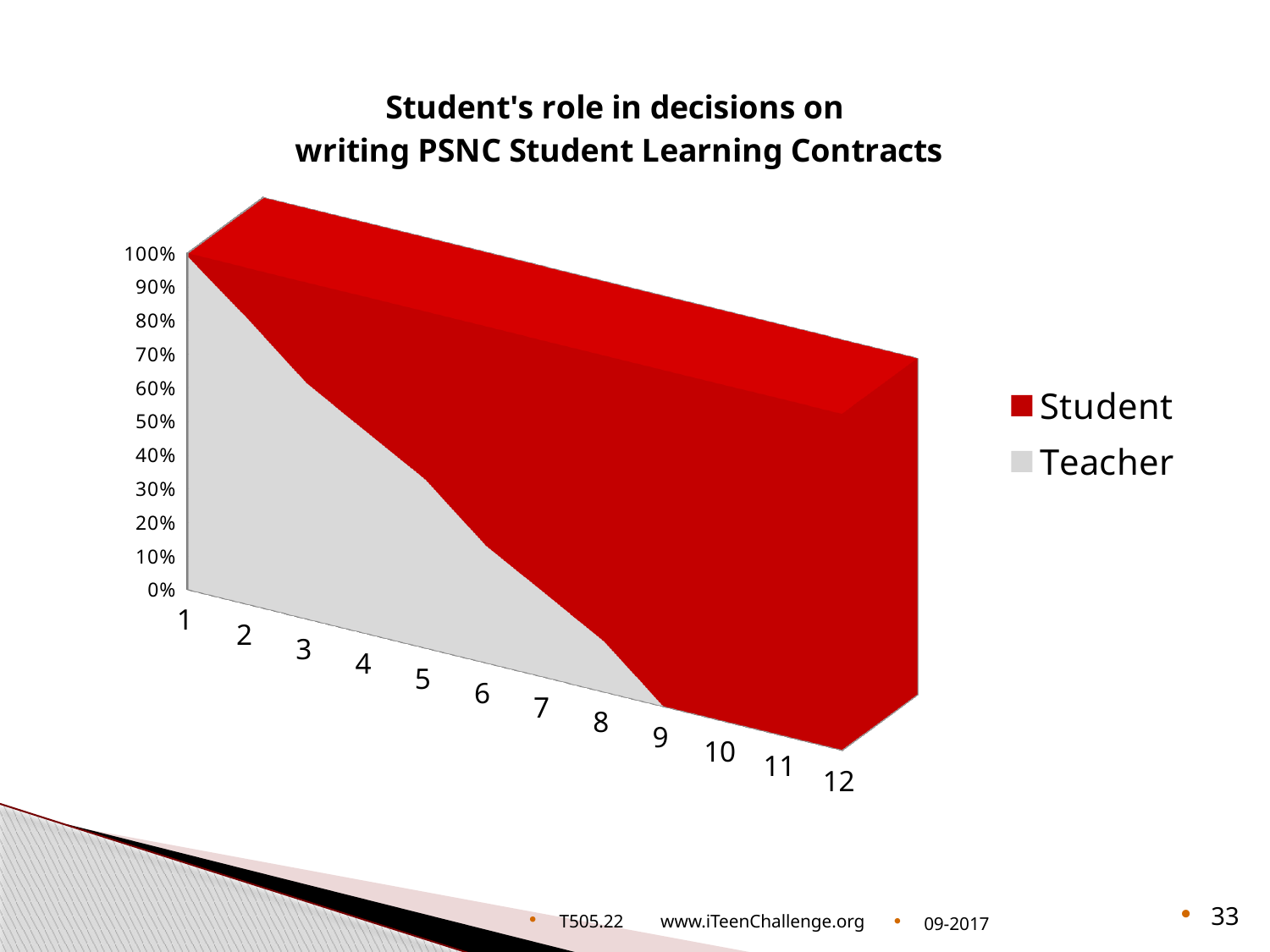
Which colour represents the Teacher series? Grey At category 3, which series has the larger share, Student or Teacher? Teacher How many series does the legend list? 2 Does the Student share rise or fall as the x axis goes from 1 to 12? Rise Does the Teacher share rise or fall as the x axis goes from 1 to 12? Fall What kind of chart is shown on the slide? Area chart How many categories are shown along the x axis? 12 Is the Teacher value at category 8 greater or less than 50%? less Is the Student value at category 7 greater or less than 50%? greater Is the Teacher value at category 2 greater or less than 50%? greater What is the title of the chart? Student's role in decisions on writing PSNC Student Learning Contracts At which category is the Teacher share highest? 1